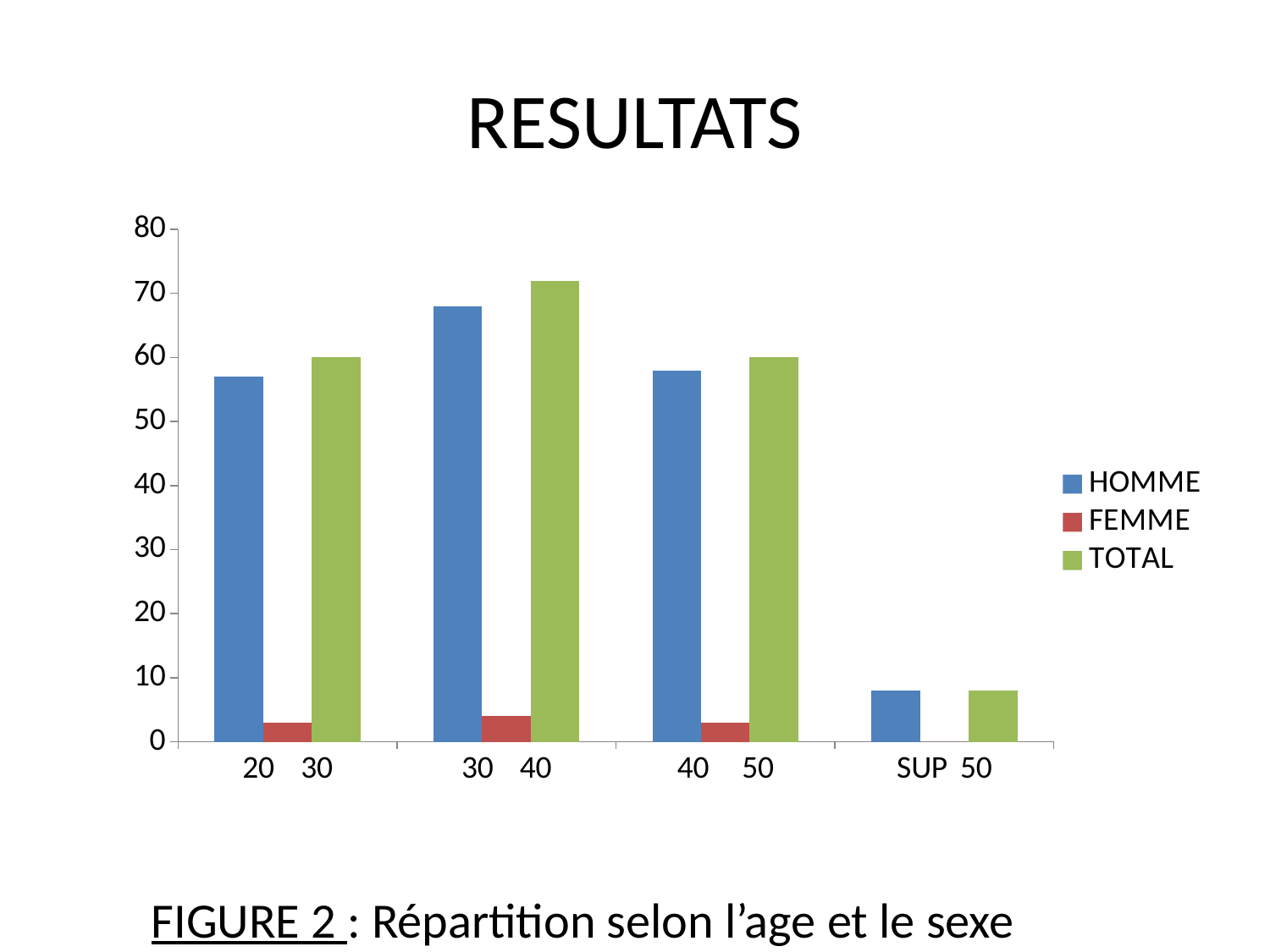
How many age categories are shown on the x axis? 4 How many series does the legend list? 3 Is the FEMME value for the 30 40 category greater or less than 10? less Which age category has the highest HOMME value? 30 40 Which age category has the lowest TOTAL value? SUP 50 What kind of chart is shown on the slide? bar chart Which is larger, the TOTAL value for 30 40 or the TOTAL value for 20 30? 30 40 Which is larger, the HOMME value for 30 40 or the HOMME value for 40 50? 30 40 Is the TOTAL value for the SUP 50 category greater or less than 10? less Is the HOMME value for the 30 40 category greater or less than 60? greater What are the three series listed in the legend? HOMME, FEMME, TOTAL